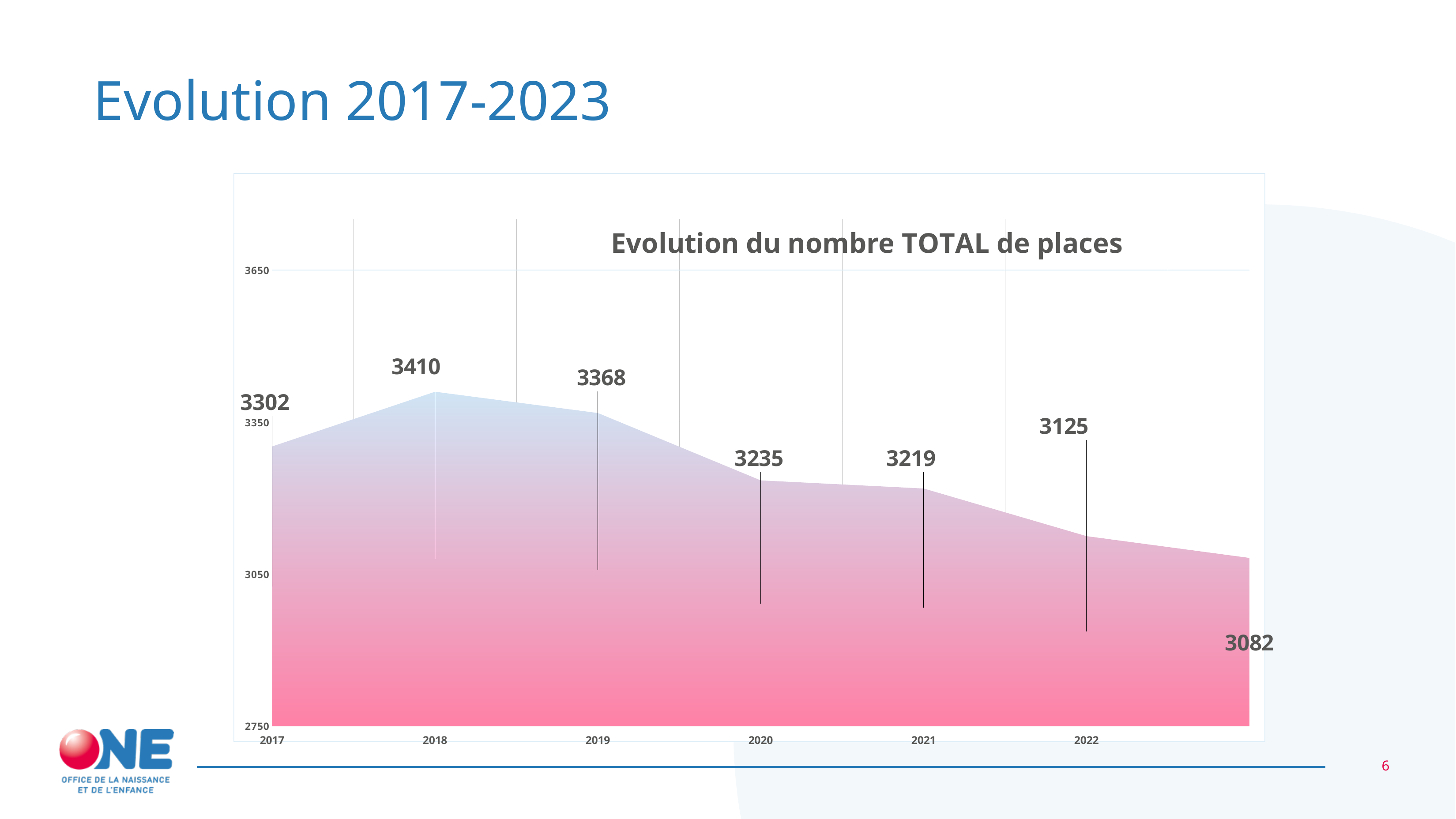
What is the difference between the values for 2019 and 2020? 133 How many data points are plotted on the chart? 7 What is the value for 2021? 3219 What kind of chart is shown on the slide? area chart What is the lowest value shown on the chart? 3082 Which year has the highest number of places? 2018 What is the title of the chart? Evolution du nombre TOTAL de places Which is larger, the value for 2020 or the value for 2021? 2020 Is the value for 2022 greater or less than 3350? less What is the difference between the values for 2018 and 2017? 108 What is the value for 2018? 3410 What is the value for 2017? 3302